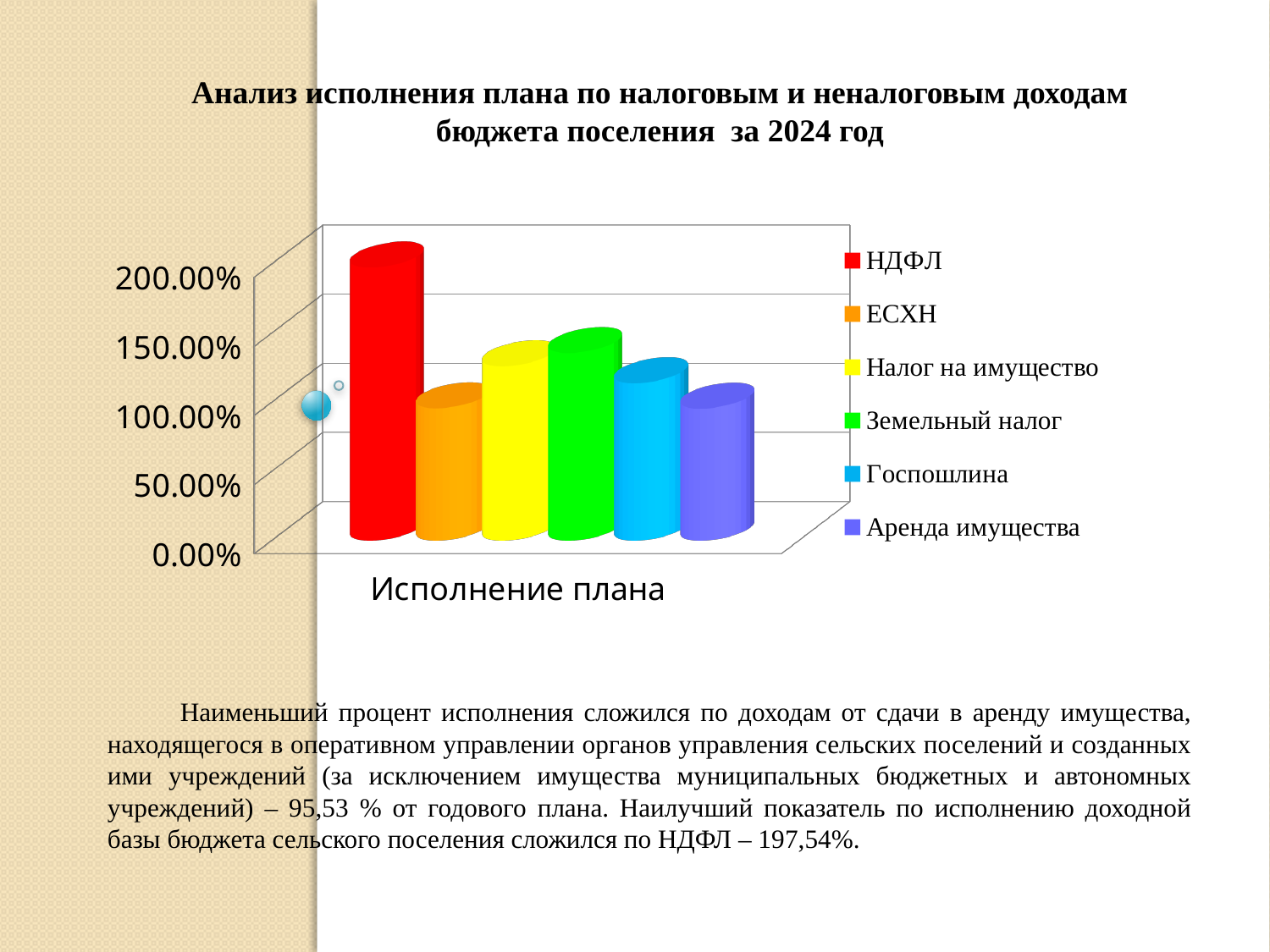
What is the label shown under the bars on the x axis? Исполнение плана Which series has the highest value in the chart? НДФЛ What is the plan execution percentage for Аренда имущества stated on the slide? 95,53 % Which is larger, the value for Земельный налог or the value for Госпошлина? Земельный налог How many series does the legend list? 6 What is the difference between the plan execution for НДФЛ (197,54%) and for Аренда имущества (95,53%)? 102,01 percentage points Is the value for Земельный налог greater or less than 100.00%? greater What kind of chart is shown on the slide? bar chart How many categories are shown on the x axis of the chart? 1 Which series has the lowest value in the chart? Аренда имущества Is the value for НДФЛ greater or less than 150.00%? greater What is the plan execution percentage for НДФЛ stated on the slide? 197,54%